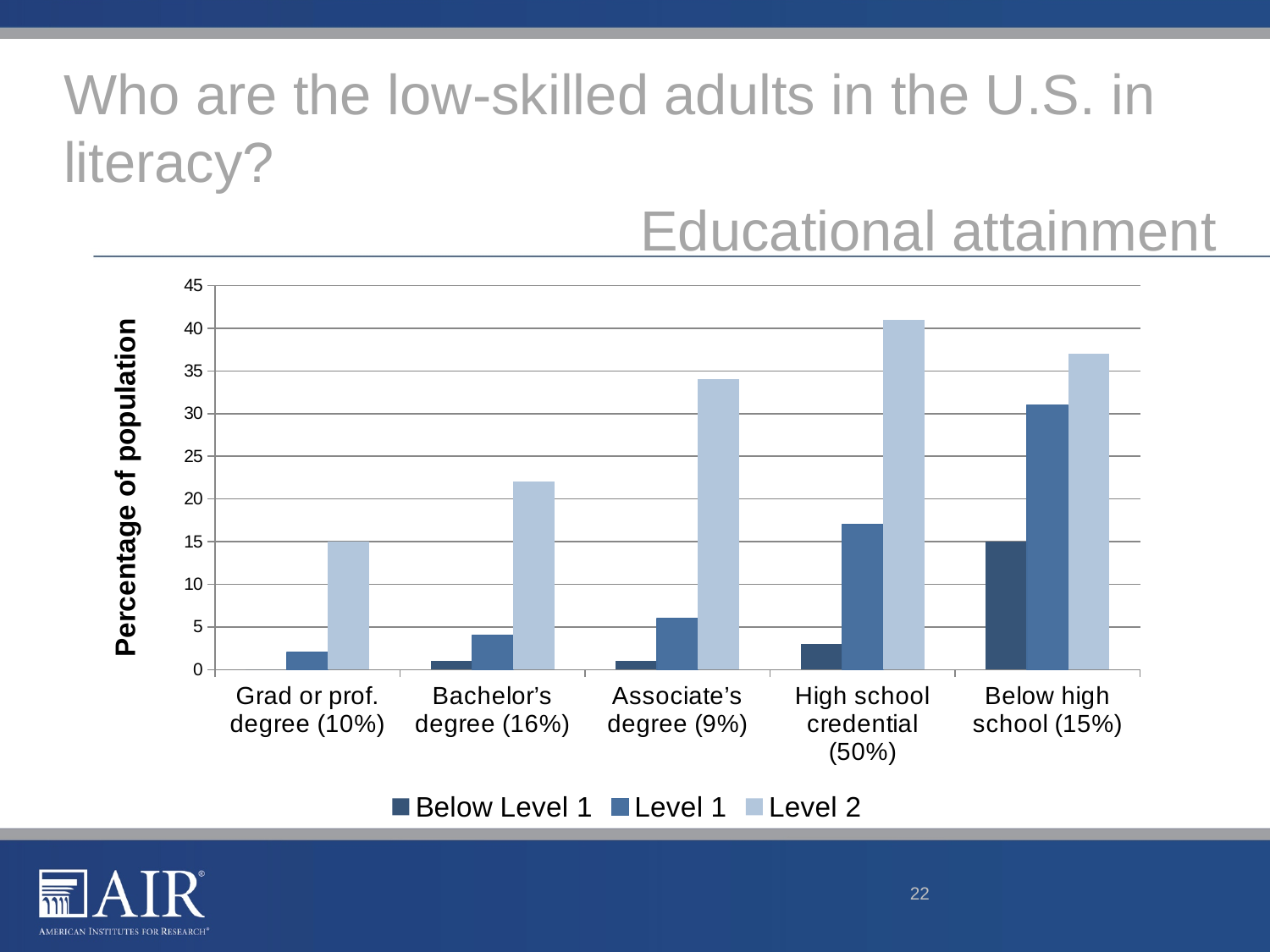
How many educational attainment categories are shown on the x axis? 5 Is the Level 2 value for Associate's degree greater or less than 30? greater Do the Level 1 values rise or fall moving from Grad or prof. degree to Below high school along the x axis? rise Which educational attainment category has the lowest Level 2 value? Grad or prof. degree (10%) Which educational attainment category has the highest Level 2 value? High school credential (50%) Which category has the highest Level 1 value? Below high school (15%) Is the Level 2 value for High school credential greater or less than 35? greater Is the Level 2 value for Bachelor's degree greater or less than 25? less What kind of chart is shown on the slide? bar chart Which is larger: the Level 1 value for Below high school or the Level 1 value for High school credential? Below high school How many series does the legend list? 3